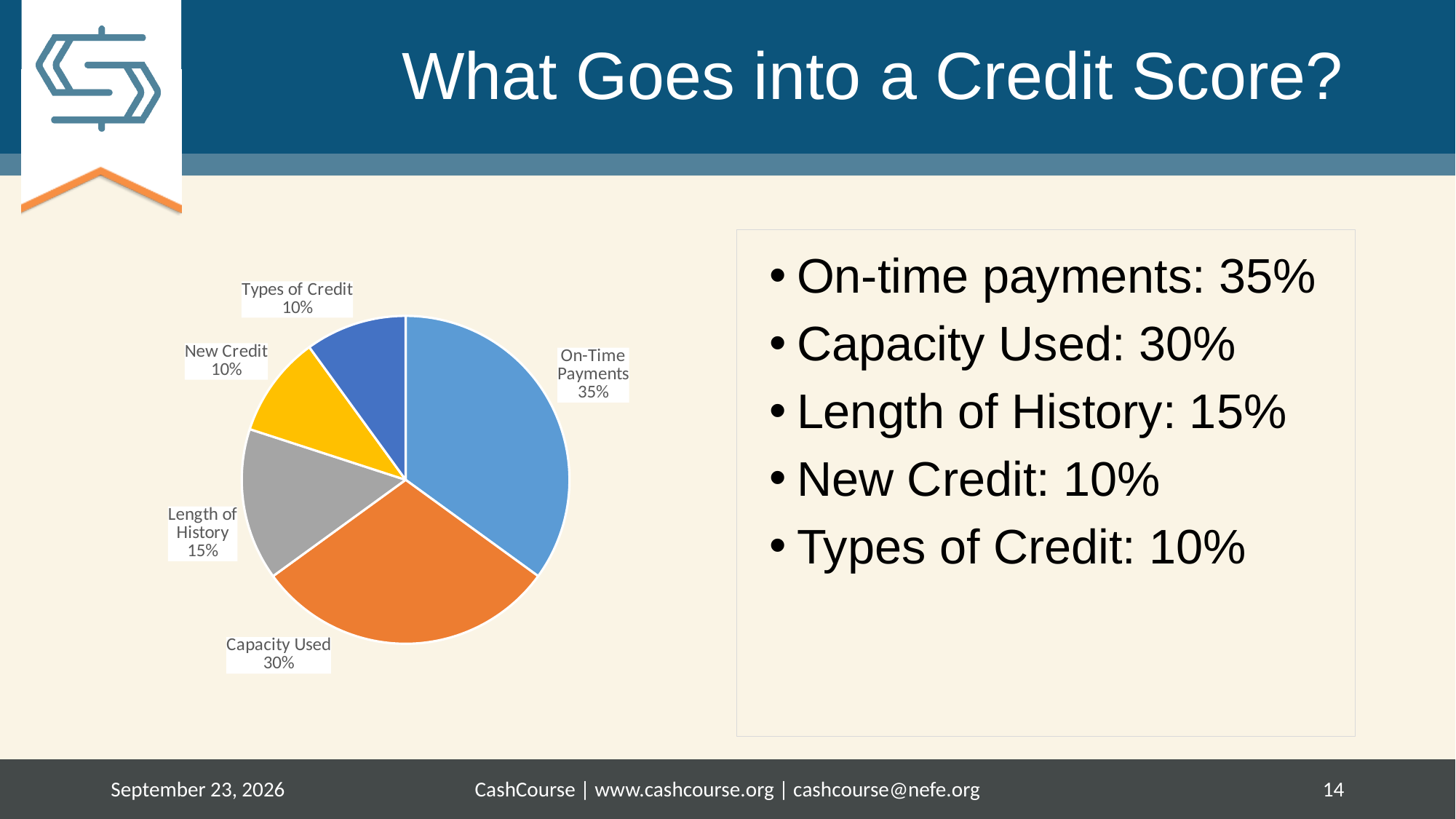
Which two categories share the same value of 10%? New Credit and Types of Credit What colour is the Capacity Used slice? Orange What is the value shown for Length of History? 15% What is the difference between the Capacity Used share and the Length of History share? 15% What is the difference between the On-Time Payments share and the Capacity Used share? 5% What kind of chart is shown on the slide? Pie chart What is the value shown for Capacity Used? 30% What is the value shown for New Credit? 10% Which category has the largest slice of the pie? On-Time Payments Which is larger, Length of History or New Credit? Length of History What share of the pie does On-Time Payments represent? 35% How many slices does the pie chart have? 5